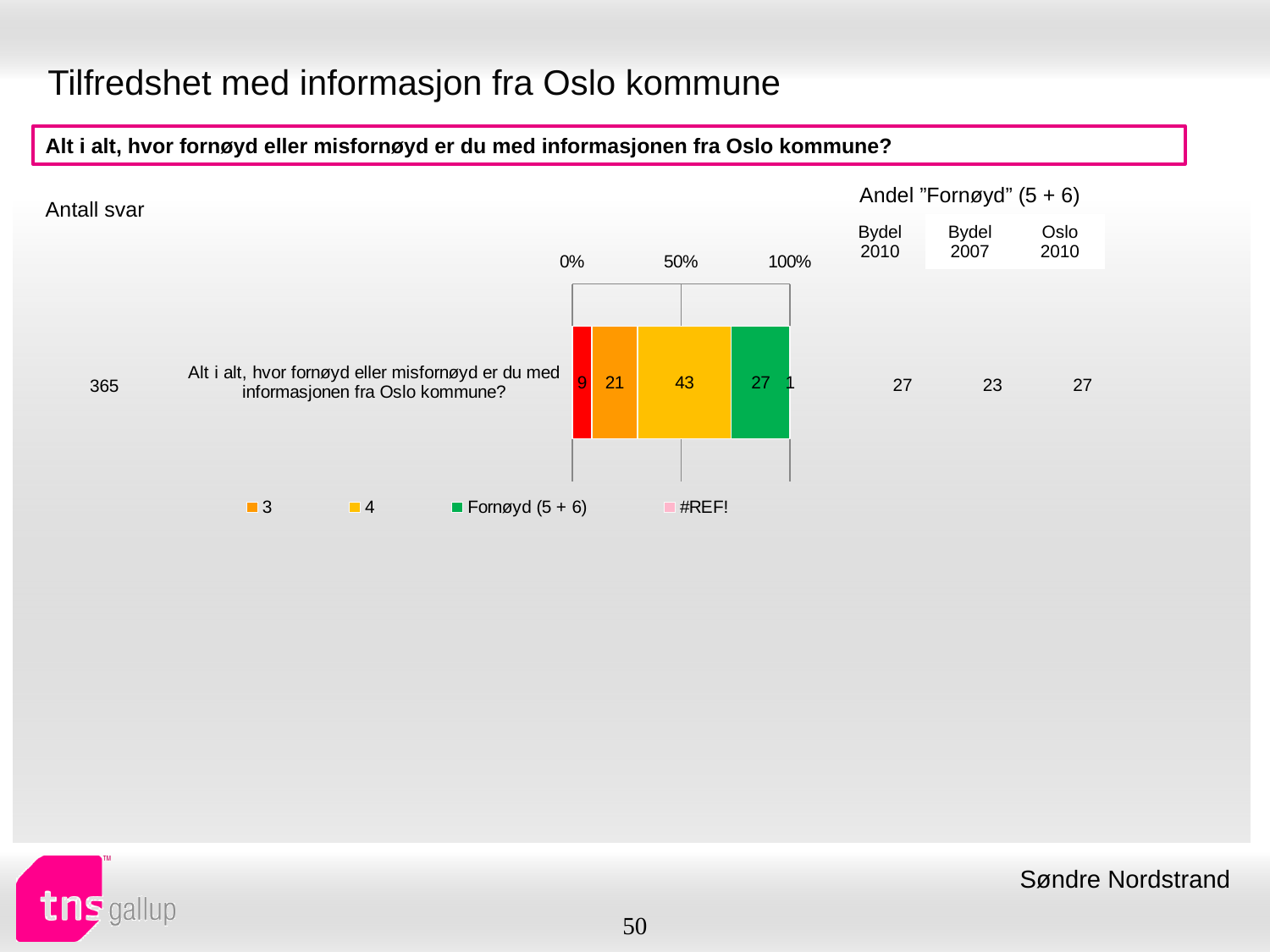
What is the value of the "#REF!" segment in the bar? 1 How many bars does the chart contain? 1 Which is larger, the "3" segment or the "Fornøyd (5 + 6)" segment? Fornøyd (5 + 6) Which legend series has the smallest segment in the bar? #REF! What kind of chart is shown on the slide? bar chart What is the difference between the "4" segment and the "Fornøyd (5 + 6)" segment? 16 What colour is the "Fornøyd (5 + 6)" segment of the bar? green What is the value of the "3" segment in the bar? 21 What is the value of the "Fornøyd (5 + 6)" segment in the bar? 27 What is the value of the "4" segment in the bar? 43 Which legend series has the largest segment in the bar? 4 How many series does the legend list? 4